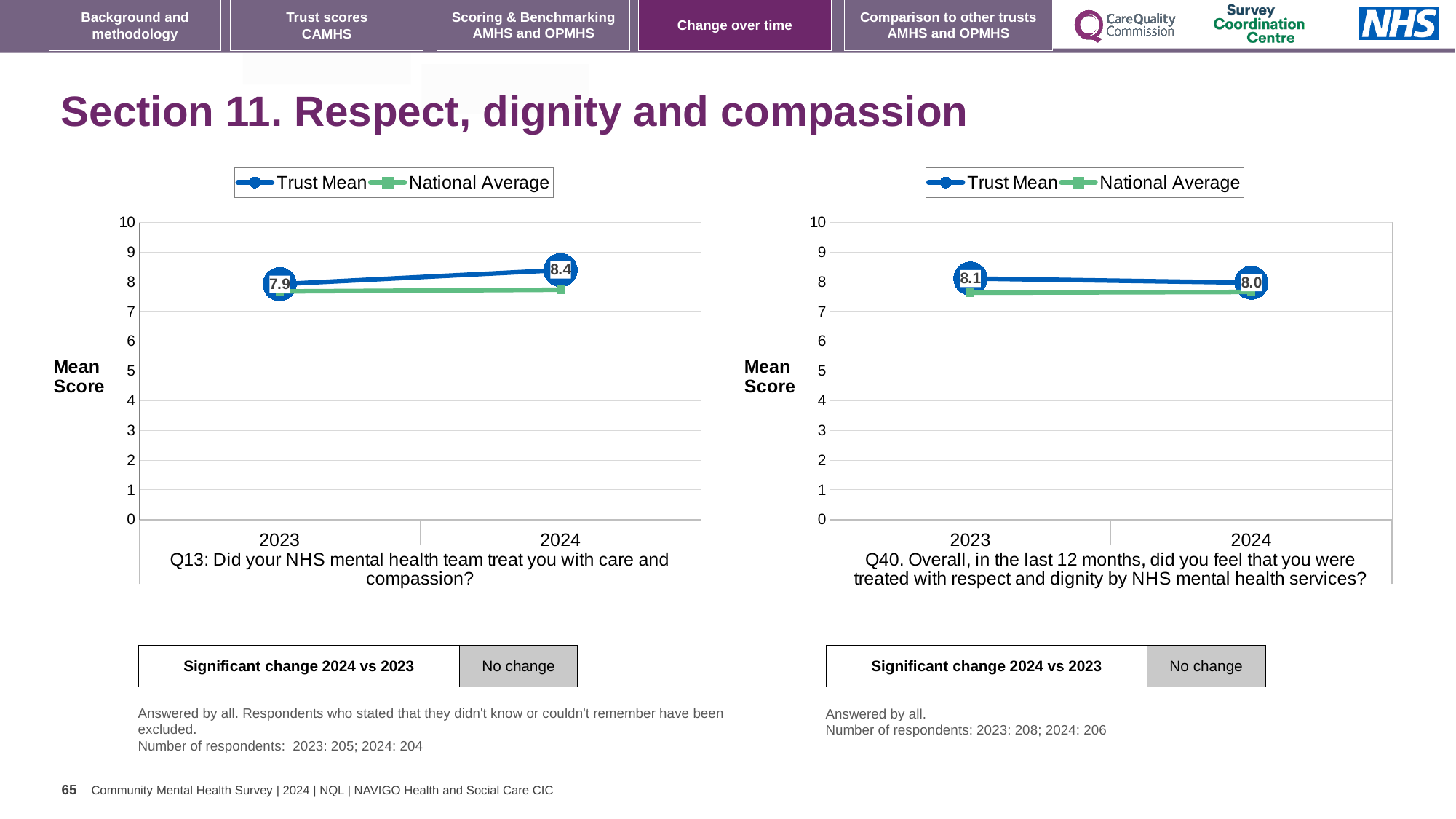
What kind of chart is the right chart (Q40)? line chart In the right chart (Q40), is the National Average value for 2024 greater or less than 8? less In the left chart (Q13), by how much did the Trust Mean change from 2023 to 2024? 0.5 In the left chart (Q13), which series has the higher value in 2024, Trust Mean or National Average? Trust Mean In the right chart (Q40), what is the Trust Mean score for 2024? 8.0 In the left chart (Q13), does the Trust Mean rise or fall from 2023 to 2024? rise In the right chart (Q40), what is the Trust Mean score for 2023? 8.1 How many series does the legend of the left chart (Q13) list? 2 In the right chart (Q40), does the Trust Mean rise or fall from 2023 to 2024? fall How many years are plotted on the x axis of the left chart (Q13)? 2 In the left chart (Q13), what is the Trust Mean score for 2023? 7.9 In the left chart (Q13), what is the Trust Mean score for 2024? 8.4